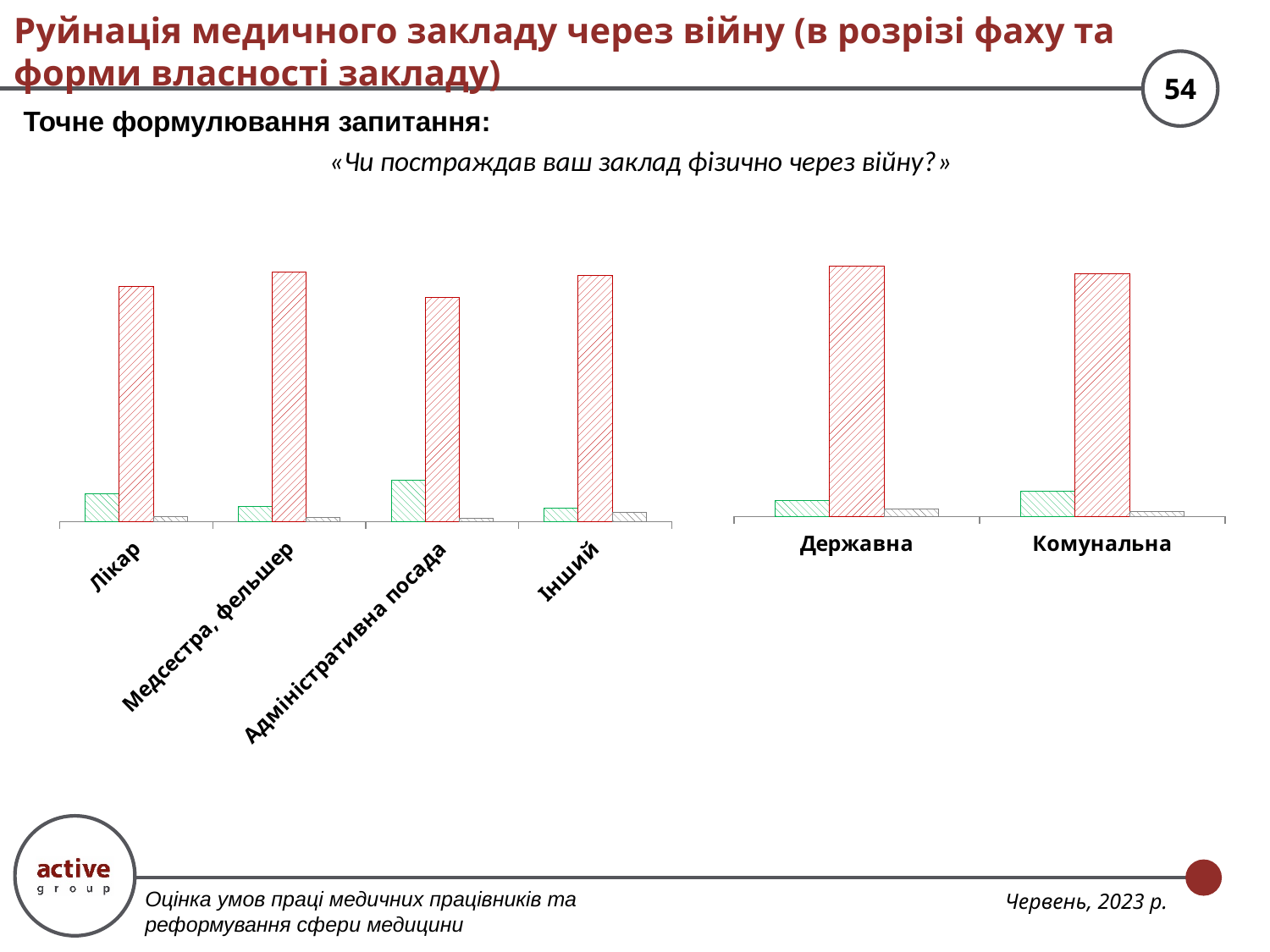
What kind of chart is the right chart on the slide? bar chart In the right chart, which category has the taller red bar? Державна In the left chart, which category has the tallest green bar? Адміністративна посада In the right chart, which category has the taller green bar? Комунальна In the left chart, which bar colour is the tallest in every category? red What kind of chart is the left chart on the slide? bar chart How many categories are shown on the x axis of the right chart? 2 In the left chart, is the red bar for Медсестра, фельшер taller or shorter than the red bar for Лікар? taller How many bars are drawn for each category in the right chart? 3 How many categories are shown on the x axis of the left chart? 4